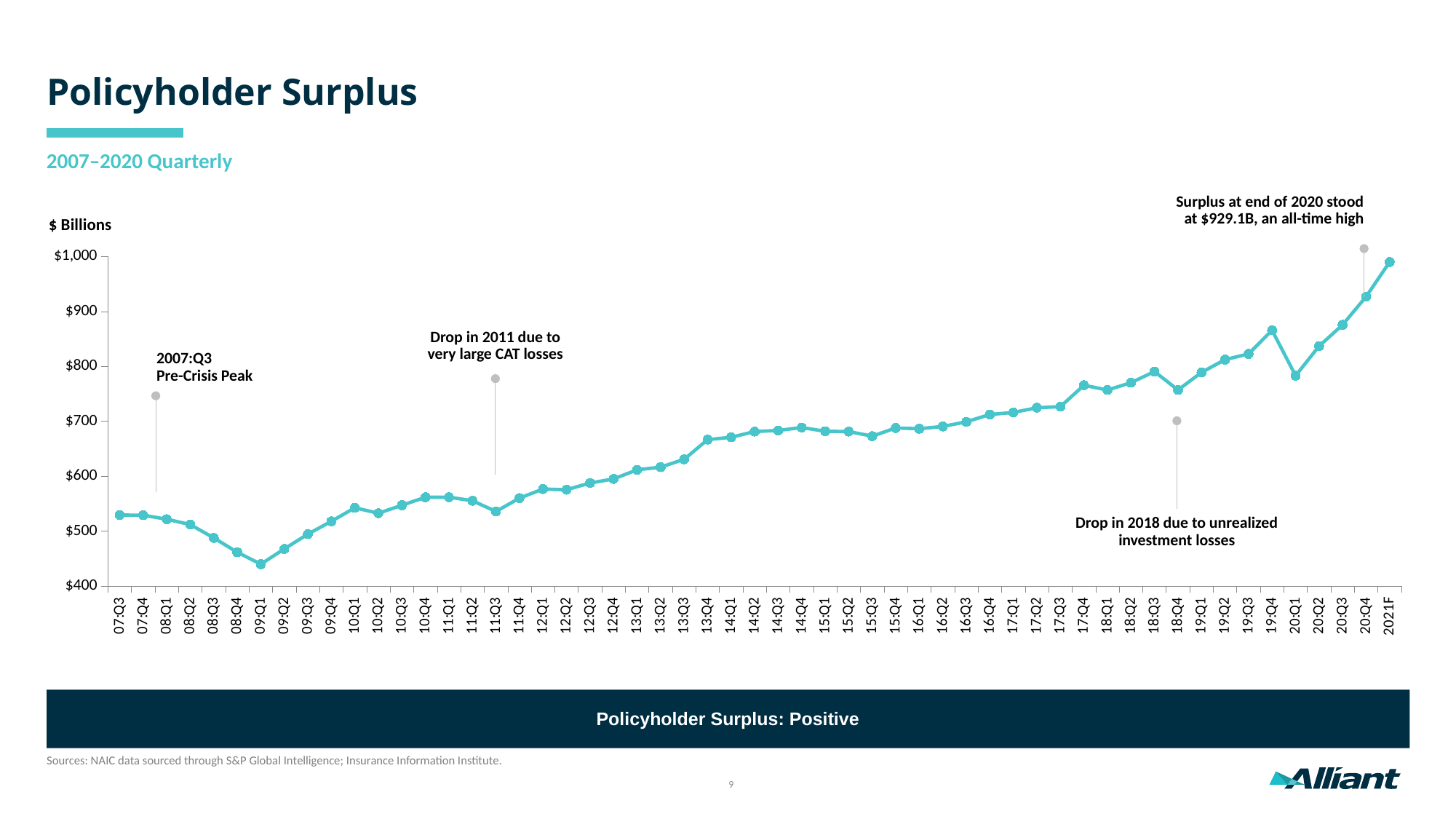
Which quarter has the lowest policyholder surplus on the chart? 09:Q1 Is the value for 20:Q4 greater or less than $900? greater Overall, do the values rise or fall from 07:Q3 to 2021F? rise According to the annotation, what was the policyholder surplus at the end of 2020? $929.1B Which point on the chart has the highest policyholder surplus? 2021F Is the value for 13:Q4 greater or less than $600? greater Is the value for 18:Q4 greater or less than $700? greater How many data points are plotted on the chart? 55 What kind of chart is shown on the slide? line chart What unit is shown for the y axis of the chart? $ Billions Which is larger, the value for 19:Q4 or the value for 20:Q1? 19:Q4